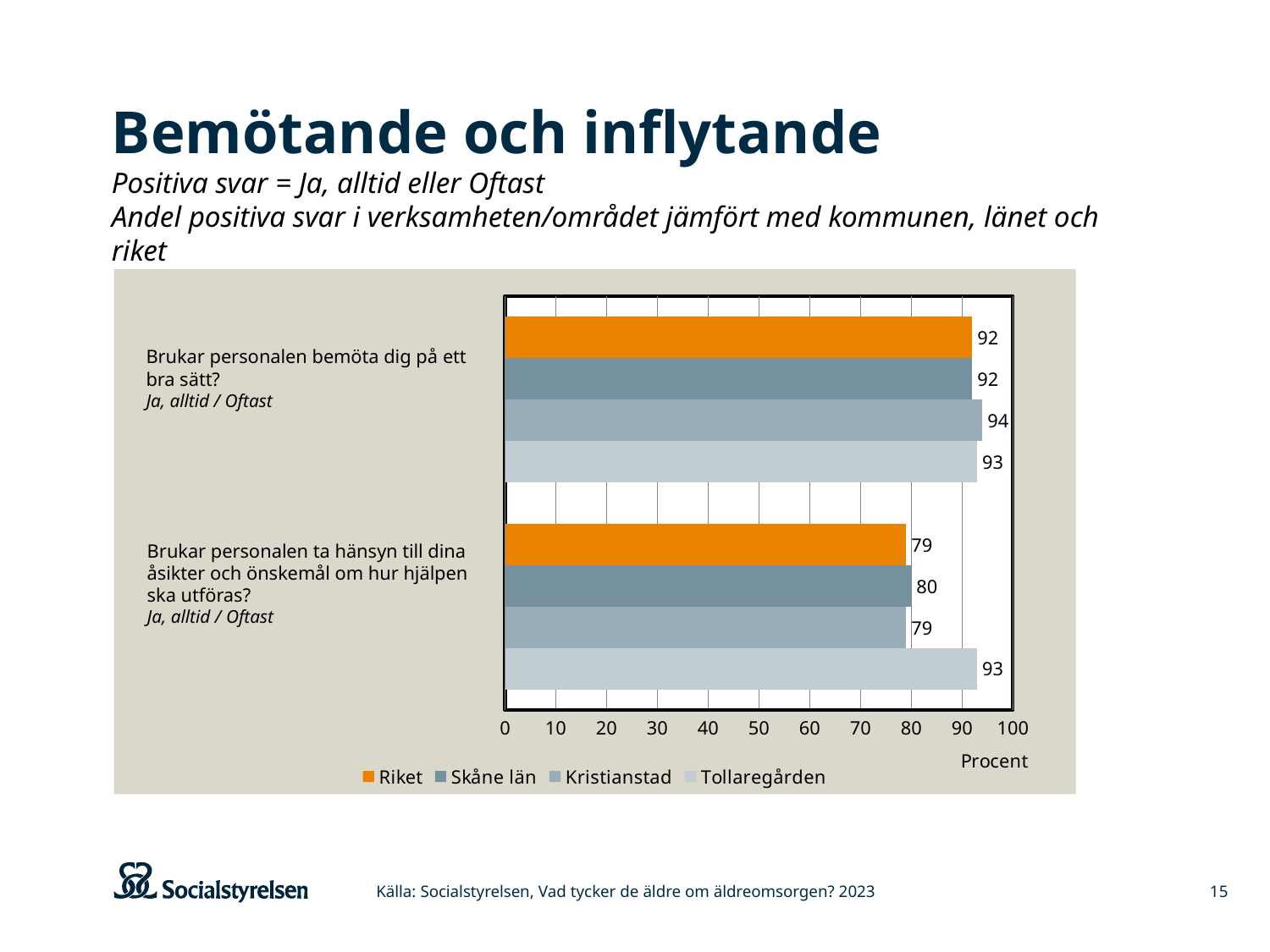
What is the value for Skåne län for the question "Brukar personalen ta hänsyn till dina åsikter och önskemål om hur hjälpen ska utföras?"? 80 What is the value for Kristianstad for the question "Brukar personalen bemöta dig på ett bra sätt?"? 94 How many questions (categories) are shown on the chart? 2 What is the value for Tollaregården for the question "Brukar personalen ta hänsyn till dina åsikter och önskemål om hur hjälpen ska utföras?"? 93 Which is larger for the question "Brukar personalen ta hänsyn till dina åsikter och önskemål om hur hjälpen ska utföras?": Tollaregården or Kristianstad? Tollaregården How many series does the legend list? 4 What unit is shown on the x axis of the chart? Procent What kind of chart is shown on the slide? bar chart Which series has the highest value for the question "Brukar personalen bemöta dig på ett bra sätt?"? Kristianstad What is the value for Riket for the question "Brukar personalen bemöta dig på ett bra sätt?"? 92 Which series has the highest value for the question "Brukar personalen ta hänsyn till dina åsikter och önskemål om hur hjälpen ska utföras?"? Tollaregården What is the difference between Tollaregården and Riket for the question "Brukar personalen ta hänsyn till dina åsikter och önskemål om hur hjälpen ska utföras?"? 14